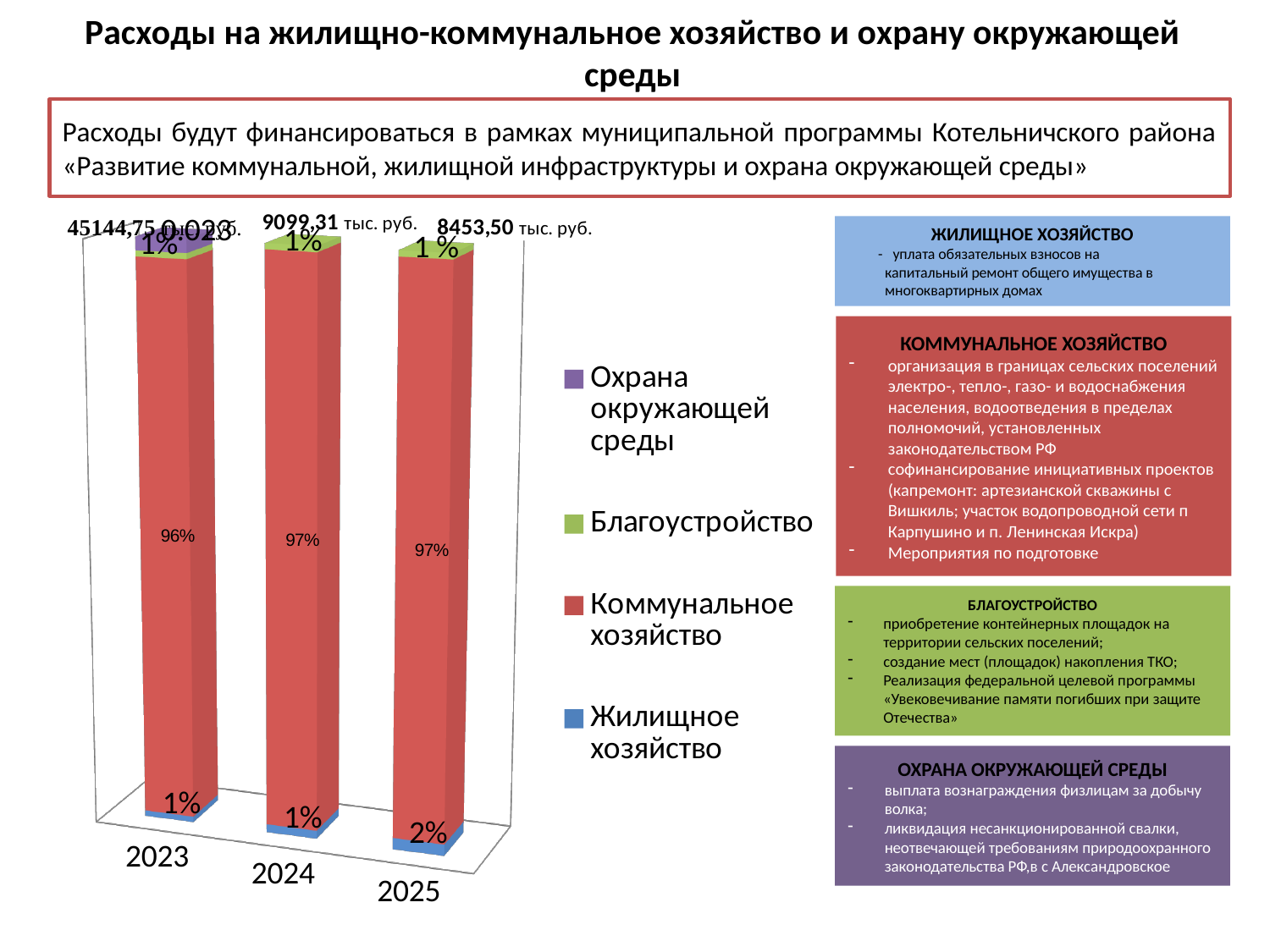
What share does Коммунальное хозяйство have in the 2024 bar? 97% What total amount is labelled above the 2025 bar? 8453,50 тыс. руб. Is the Коммунальное хозяйство share larger in 2023 or in 2024? 2024 What total amount is labelled above the 2024 bar? 9099,31 тыс. руб. Which year has the lowest share for Коммунальное хозяйство? 2023 What kind of chart is shown on the slide? Stacked bar chart What share does Коммунальное хозяйство have in the 2023 bar? 96% By how many percentage points does the Коммунальное хозяйство share in 2025 exceed that in 2023? 1 How many series does the chart legend list? 4 How many years (categories) are shown on the x axis of the chart? 3 Which colour represents Коммунальное хозяйство in the chart legend? Red What share does Жилищное хозяйство have in the 2025 bar? 2%